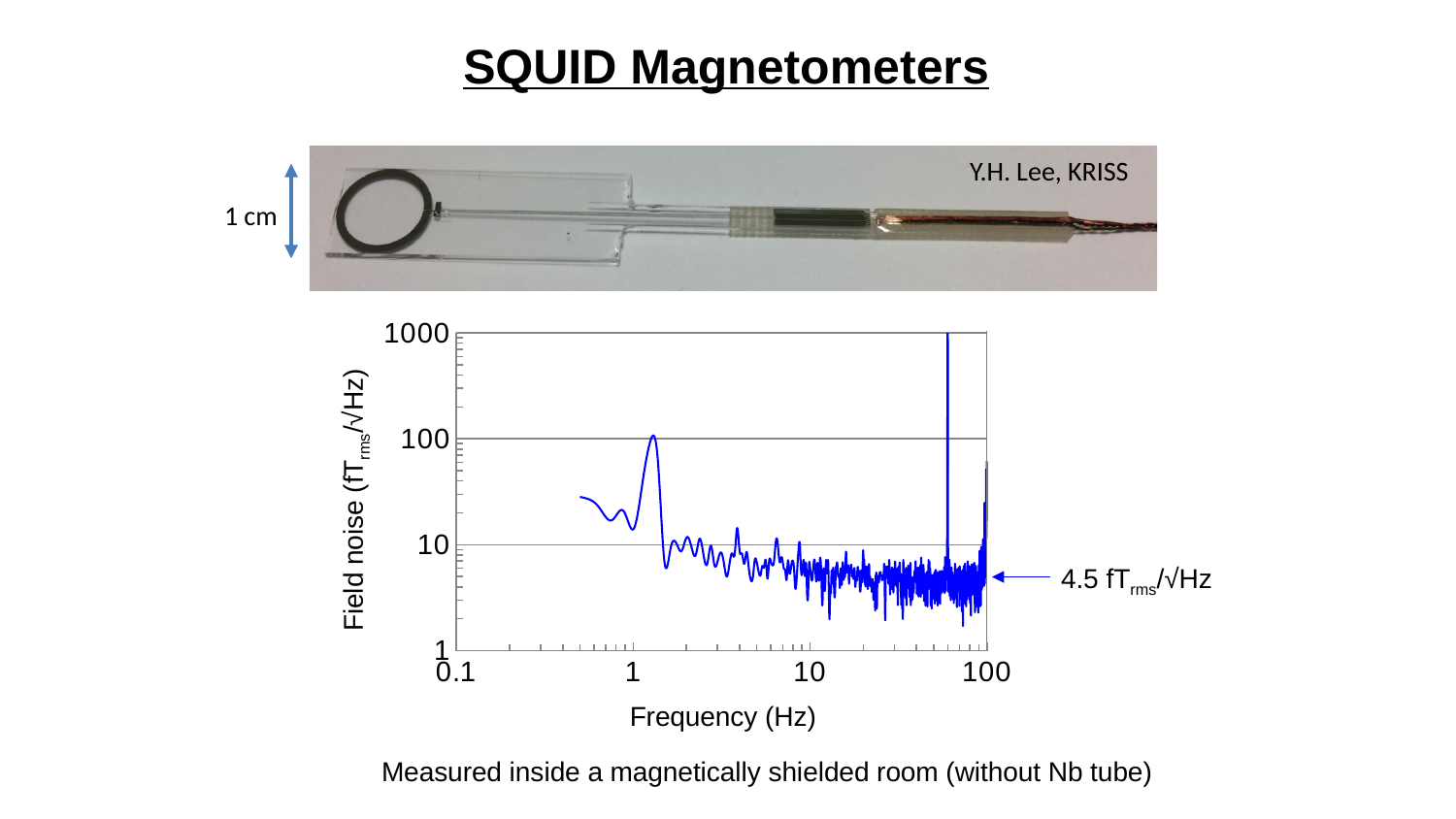
How many data series are plotted on the chart? 1 Is the field noise at 1 Hz greater or less than 10? greater Is the peak of the narrow spike near 60 Hz greater or less than 100? greater What is the label of the y axis of the chart? Field noise (fT_rms/√Hz) What kind of chart is shown on the slide? line chart What is the label of the x axis of the chart? Frequency (Hz) Is the field noise at 10 Hz greater or less than 10? less Overall, does the field noise rise or fall as frequency increases from 0.5 Hz to 50 Hz? fall What noise level does the arrow annotation on the right of the chart indicate? 4.5 fT_rms/√Hz